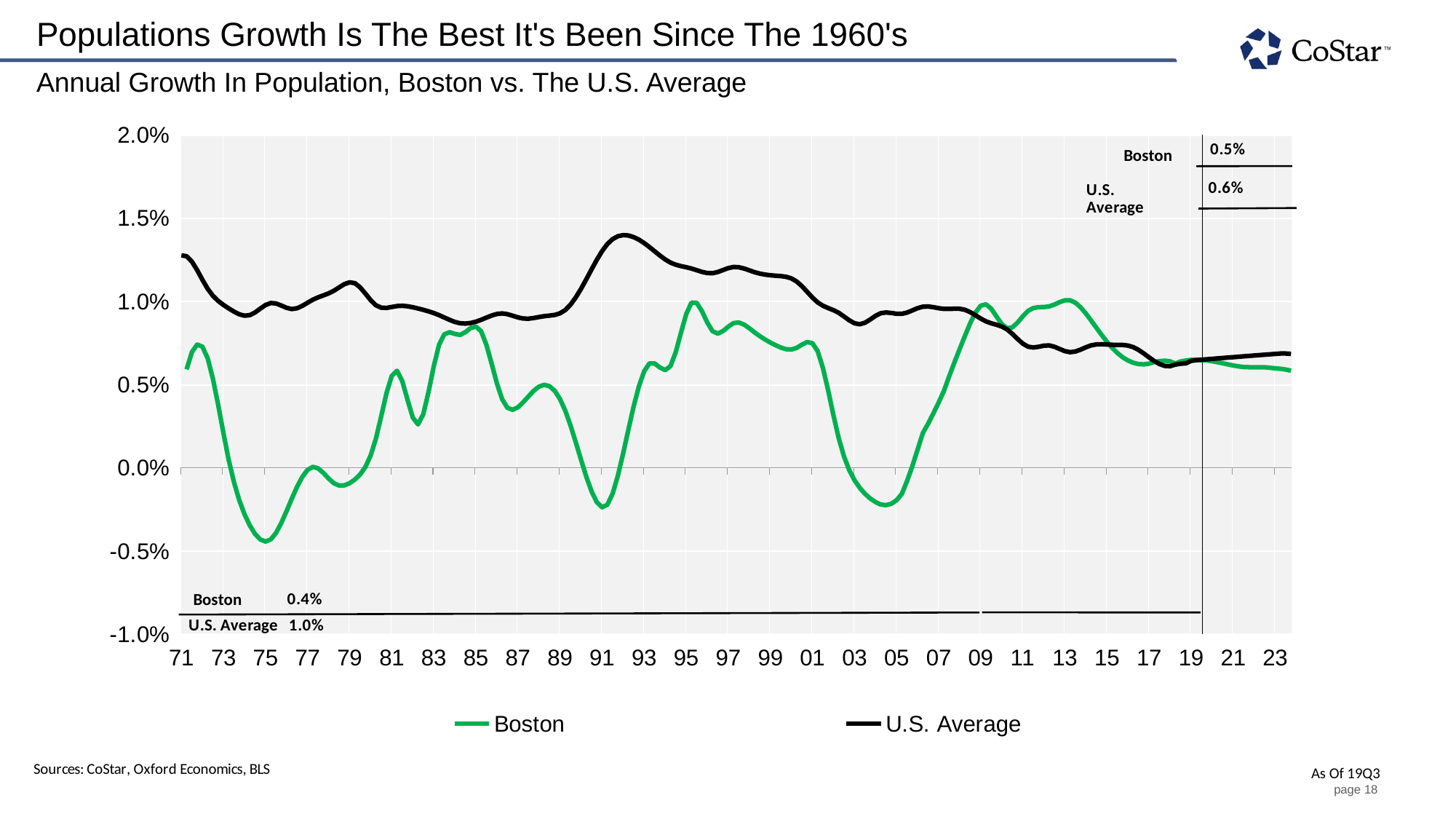
Is the U.S. Average annual population growth value in 1992 greater or less than 1.0%? greater Is the Boston annual population growth value in 1975 greater or less than 0.0%? less In 2013, which series has the higher annual population growth, Boston or U.S. Average? Boston In 1991, which series has the higher annual population growth, Boston or U.S. Average? U.S. Average Which colour is used for the Boston line in the chart? green How many series does the legend list? 2 What is the historical average annual population growth shown for Boston in the annotation at the bottom left of the chart? 0.4% What is the difference between the historical average growth for the U.S. Average (1.0%) and for Boston (0.4%)? 0.6% What kind of chart is shown on the slide? line chart What is the forecast-period average annual population growth shown for Boston in the annotation at the top right of the chart? 0.5% What is the forecast-period average annual population growth shown for the U.S. Average in the annotation at the top right of the chart? 0.6% What is the historical average annual population growth shown for the U.S. Average in the annotation at the bottom left of the chart? 1.0%